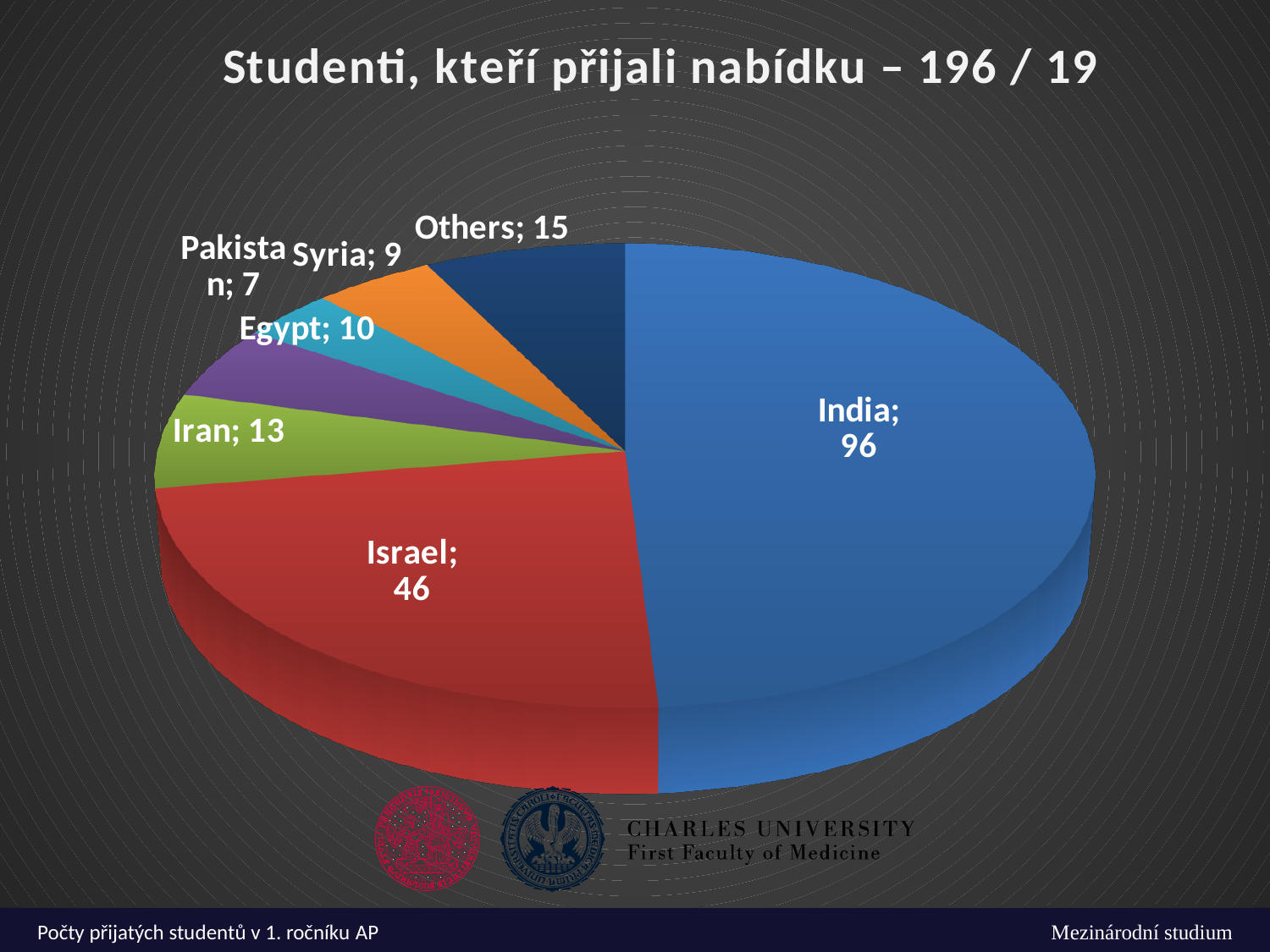
Which country has the largest slice of the pie? India What is the value shown for Pakistan? 7 What is the total of all the slice values in the pie chart? 196 How many slices does the pie chart have? 7 How many students from India accepted the offer according to the chart? 96 What is the difference between the values for India and Israel? 50 Which is larger, the value for Iran or the value for Egypt? Iran What is the value shown for Egypt? 10 Which labelled category has the smallest slice of the pie? Pakistan What is the value shown for Israel? 46 What is the title of the chart? Studenti, kteří přijali nabídku – 196 / 19 What type of chart is shown on the slide? pie chart